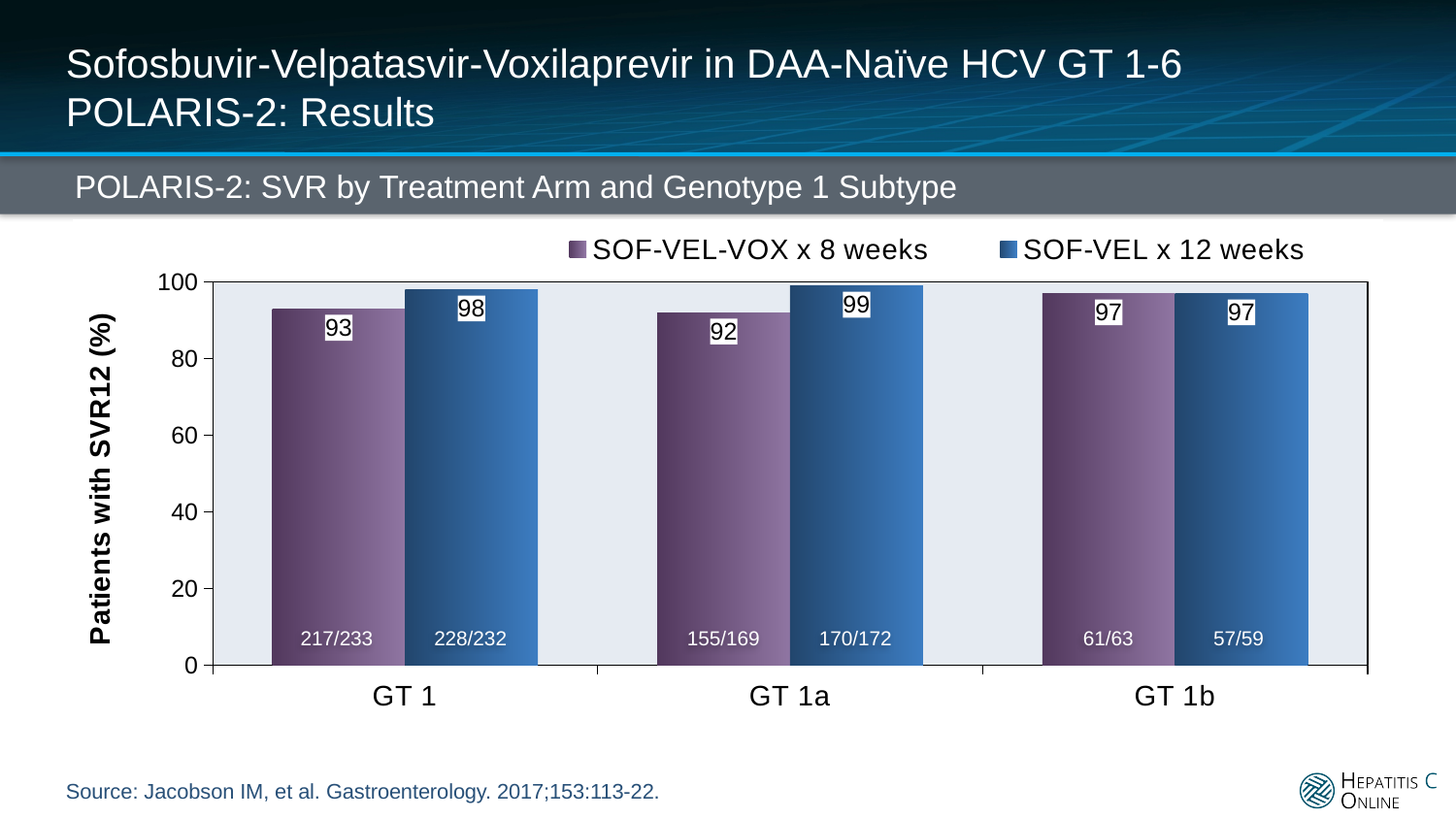
What is the difference between the SOF-VEL x 12 weeks and SOF-VEL-VOX x 8 weeks SVR12 rates in GT 1a? 7 How many genotype subtype categories are shown on the x axis? 3 Which genotype subtype has the highest SVR12 rate for SOF-VEL x 12 weeks? GT 1a How many series does the legend list? 2 What is the SVR12 rate for SOF-VEL-VOX x 8 weeks in GT 1? 93 What fraction of patients is shown for SOF-VEL x 12 weeks in GT 1? 228/232 Which genotype subtype has the lowest SVR12 rate for SOF-VEL-VOX x 8 weeks? GT 1a In GT 1, which treatment arm has the higher SVR12 rate? SOF-VEL x 12 weeks What is the SVR12 rate for SOF-VEL-VOX x 8 weeks in GT 1b? 97 What is the label of the y axis? Patients with SVR12 (%) What kind of chart is shown on the slide? Bar chart What is the SVR12 rate for SOF-VEL x 12 weeks in GT 1a? 99